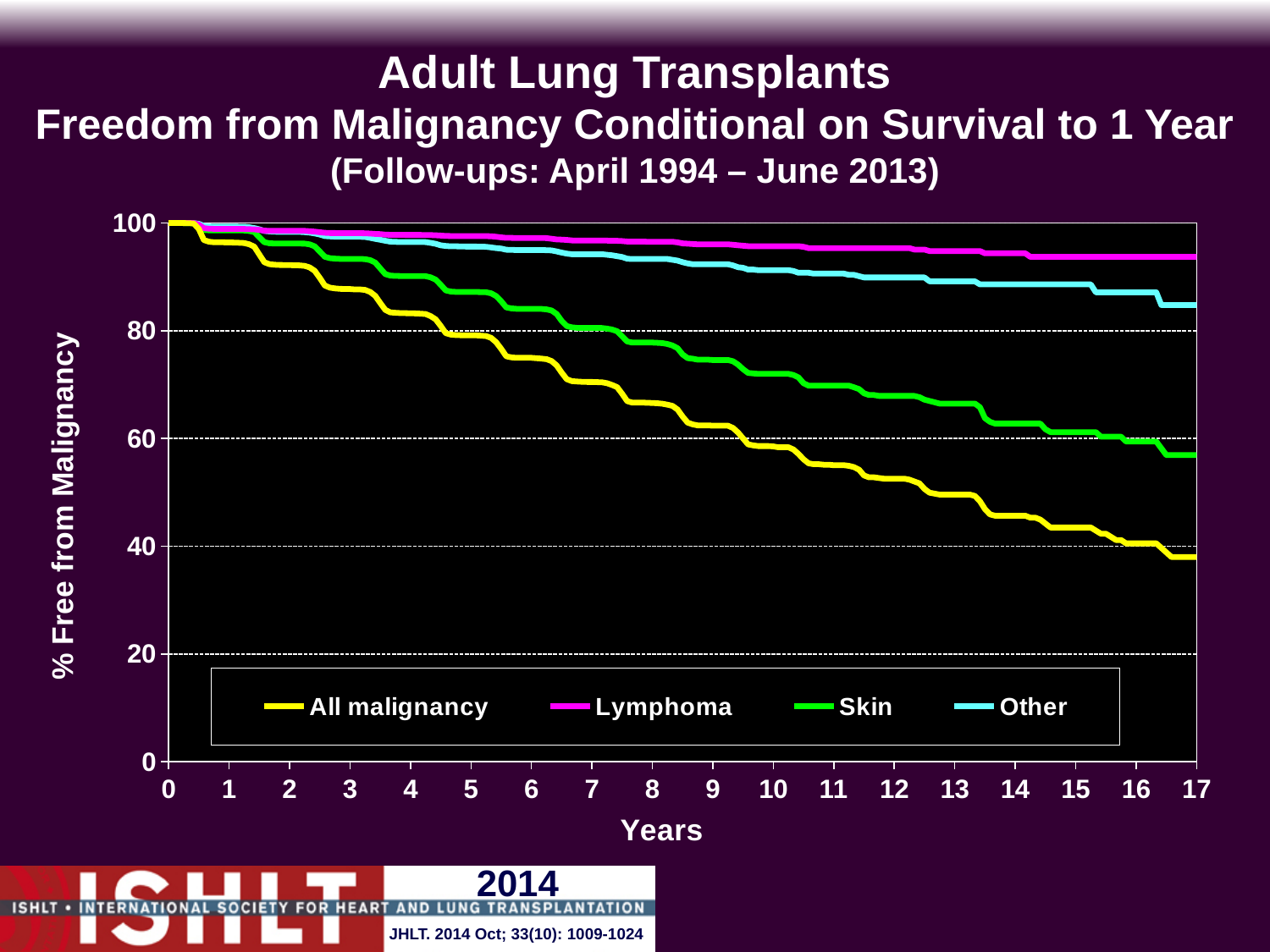
How many series does the legend list? 4 Which series has the lowest value at year 17? All malignancy Does the All malignancy curve rise or fall as years increase? fall What kind of chart is shown on the slide? line chart What is the value for All malignancy at year 0? 100 At year 17, which is higher, Lymphoma or Other? Lymphoma Is the value for Other at year 17 greater or less than 80? greater Is the value for All malignancy at year 8 greater or less than 60? greater What is the label on the y axis? % Free from Malignancy Which series has the highest value at year 17? Lymphoma Is the value for Skin at year 10 greater or less than 60? greater